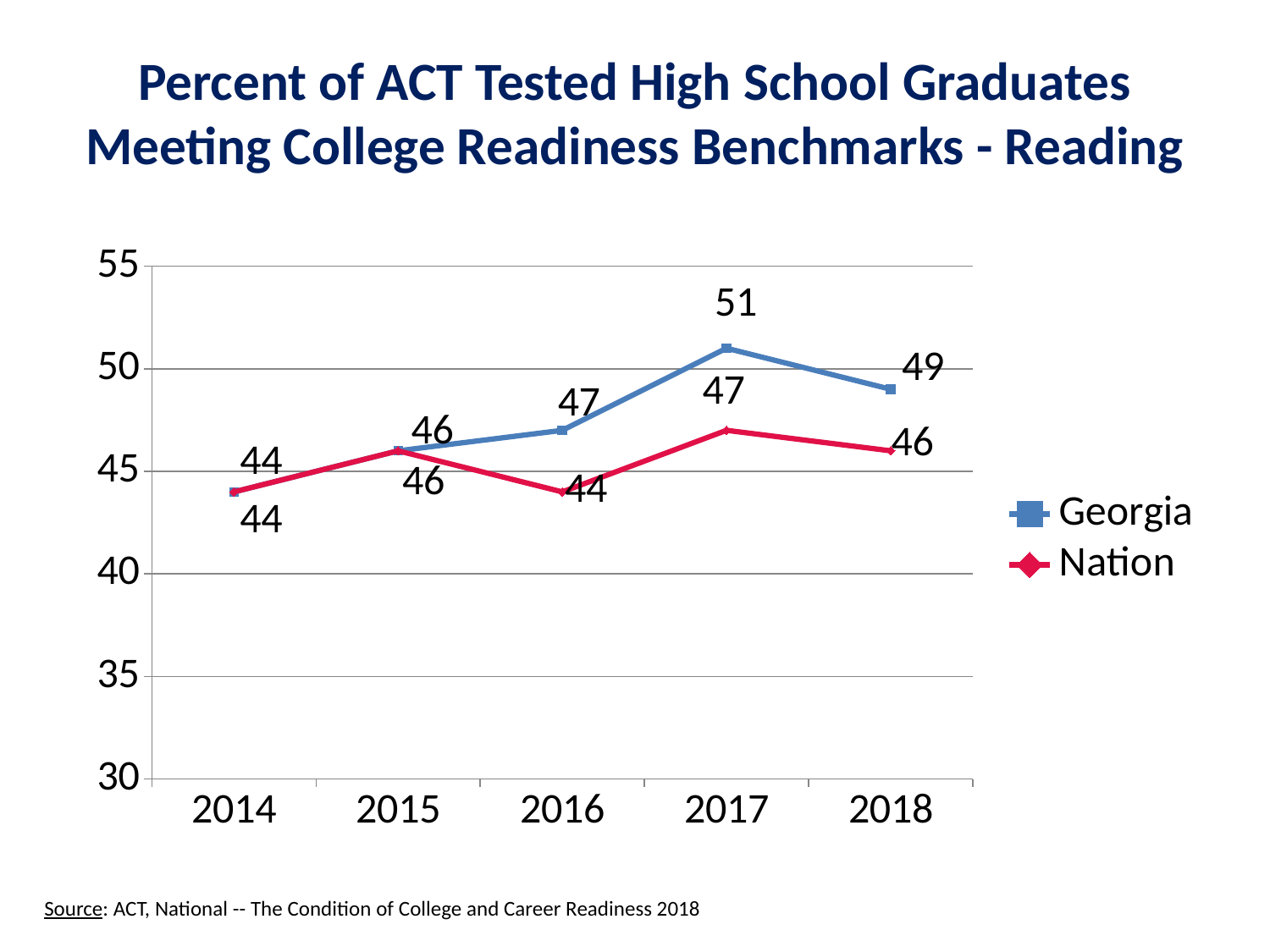
In which year is the Georgia value highest? 2017 Is the Georgia value for 2017 greater or less than 50? greater In which year is the Georgia value lowest? 2014 What is the Georgia value for 2017? 51 Does the Georgia value rise or fall from 2014 to 2017? rise How many years are shown on the x axis? 5 What is the Georgia value for 2018? 49 What is the difference between the Georgia and Nation values in 2017? 4 Which is larger in 2018, the Georgia value or the Nation value? Georgia How many series does the legend list? 2 What is the Nation value for 2016? 44 What kind of chart is shown on the slide? line chart